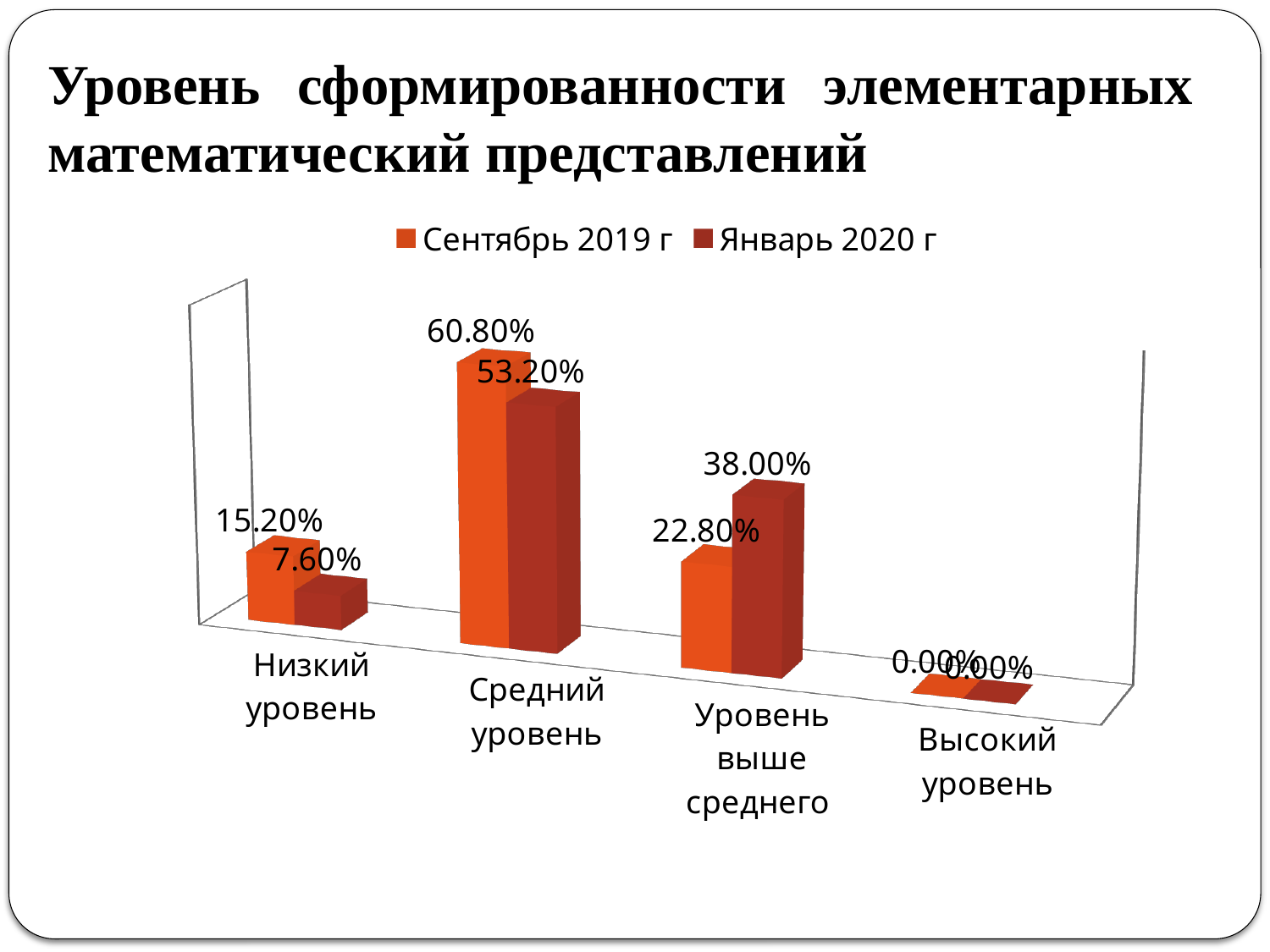
What are the two series named in the legend? Сентябрь 2019 г and Январь 2020 г For Средний уровень, which series has the larger value, Сентябрь 2019 г or Январь 2020 г? Сентябрь 2019 г What is the value for Низкий уровень in the Январь 2020 г series? 7.60% How many series does the legend list? 2 What is the difference between the Сентябрь 2019 г and Январь 2020 г values for Низкий уровень? 7.60% Which category has the lowest value in the Январь 2020 г series? Высокий уровень Which category has the highest value in the Сентябрь 2019 г series? Средний уровень What is the value for Средний уровень in the Сентябрь 2019 г series? 60.80% What is the value for Уровень выше среднего in the Январь 2020 г series? 38.00% How many categories are shown on the x axis? 4 What is the difference between the Январь 2020 г and Сентябрь 2019 г values for Уровень выше среднего? 15.20% What kind of chart is shown on the slide? bar chart